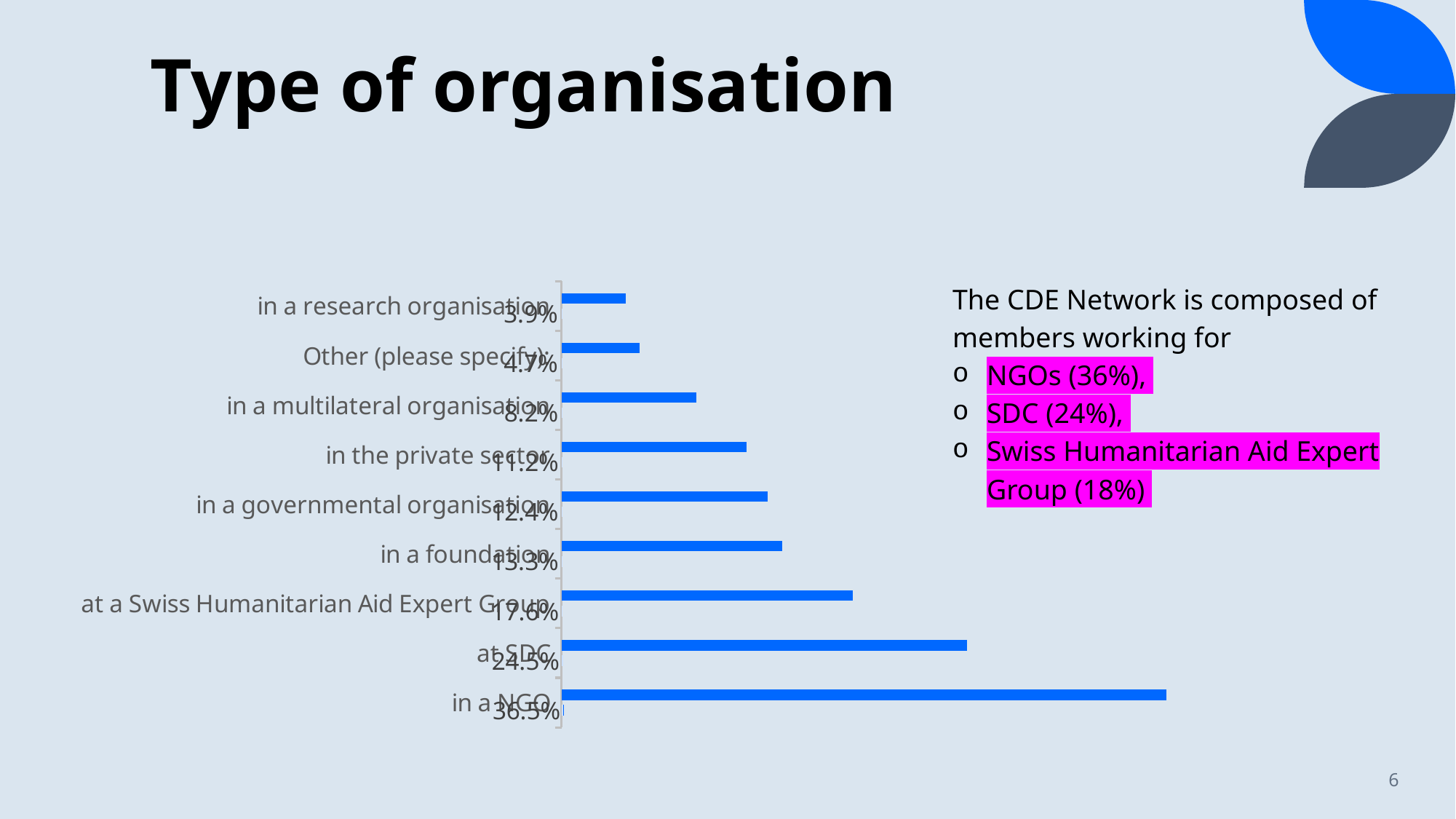
What colour are the bars in the chart? blue What is the value shown for 'in the private sector'? 11.2% How many categories of organisation does the chart show? 9 What is the difference between the values for 'in a NGO' and 'at SDC'? 12.0 percentage points What is the value shown for 'in a multilateral organisation'? 8.2% What kind of chart is shown on the slide? bar chart Which is larger, the value for 'in a foundation' or the value for 'in a governmental organisation'? in a foundation What is the value shown for 'in a NGO'? 36.5% Which type of organisation has the lowest value in the chart? in a research organisation Which type of organisation has the highest value in the chart? in a NGO What is the value shown for 'at SDC'? 24.5% What is the value shown for 'at a Swiss Humanitarian Aid Expert Group'? 17.6%